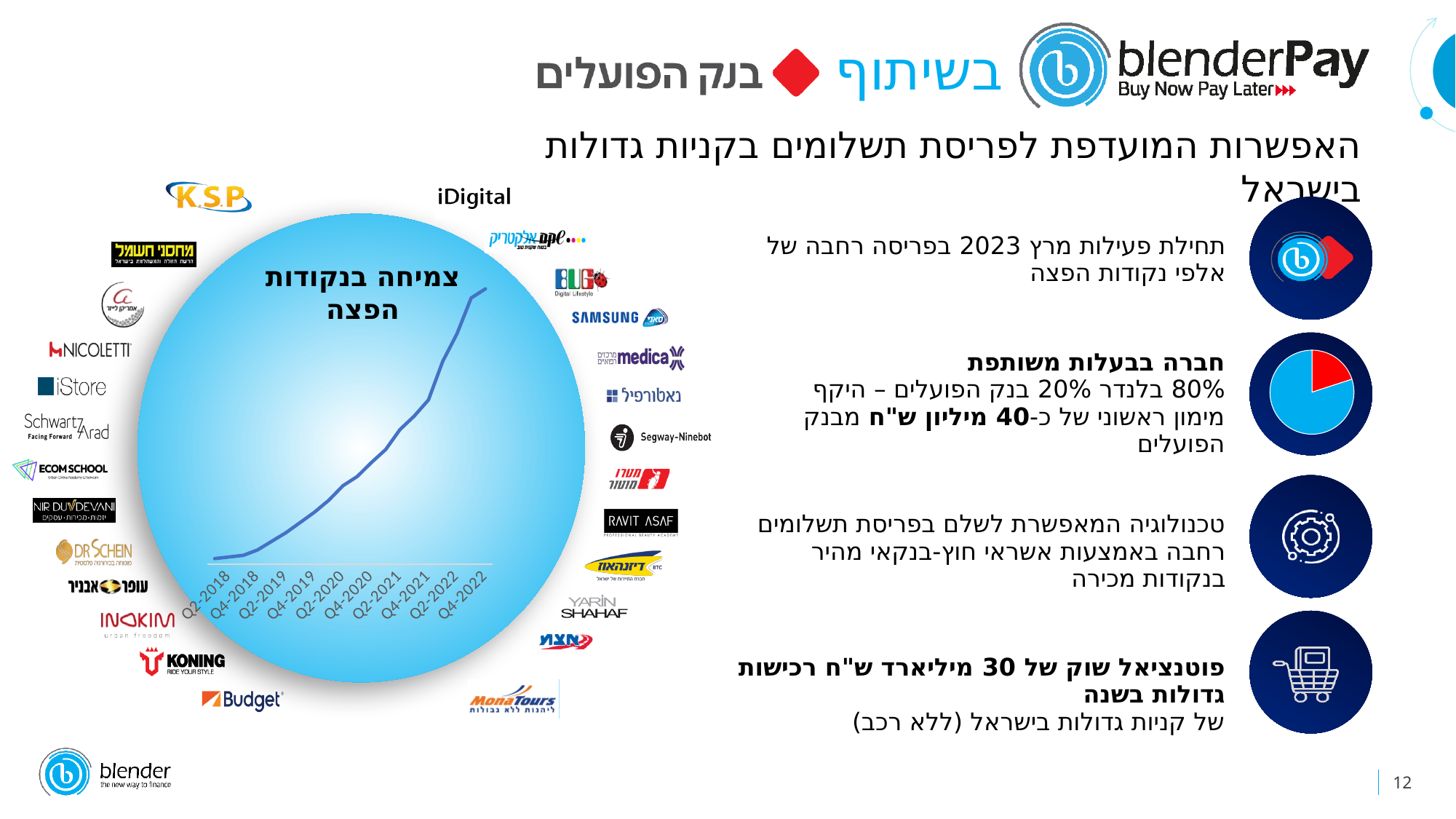
Is the value for Q2-2019 on the line chart larger or smaller than the value for Q4-2021? smaller Is the value for Q4-2022 on the line chart larger or smaller than the value for Q2-2020? larger Which quarter on the line chart has the highest value? Q4-2022 Which quarter on the line chart has the lowest value? Q2-2018 How many lines (series) are plotted on the line chart? 1 Do the values in the line chart rise or fall from Q2-2018 to Q4-2022? rise What is the title of the line chart inside the blue circle? צמיחה בנקודות הפצה How many x-axis labels (quarters) are shown on the line chart? 10 What kind of chart is shown inside the blue circle on the left of the slide? line chart What is the first x-axis label on the line chart? Q2-2018